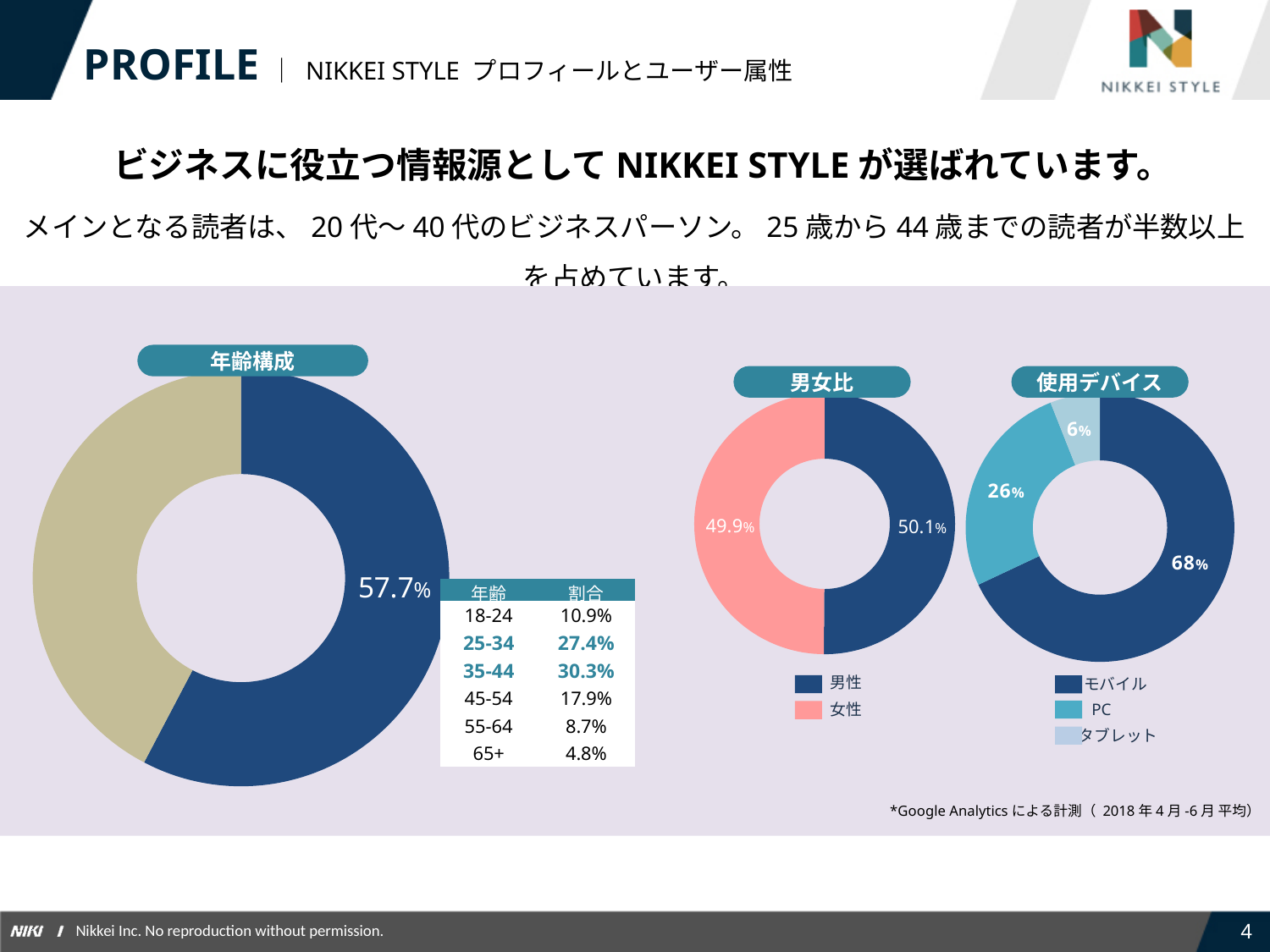
In the 男女比 chart, what percentage is shown for 男性? 50.1% In the 年齢構成 chart, what percentage is printed on the blue segment? 57.7% In the 使用デバイス chart, what percentage is shown for PC? 26% How many entries does the legend of the 使用デバイス chart list? 3 In the 使用デバイス chart, which device has the smallest share? タブレット In the 使用デバイス chart, what percentage is shown for モバイル? 68% In the 男女比 chart, what percentage is shown for 女性? 49.9% In the 年齢構成 table, what is the 割合 for the 35-44 age group? 30.3% In the 使用デバイス chart, what is the difference between the モバイル and PC shares? 42% What kind of chart is the 年齢構成 chart? Donut (pie) chart How many entries does the legend of the 男女比 chart list? 2 In the 年齢構成 table, which age group has the lowest 割合? 65+